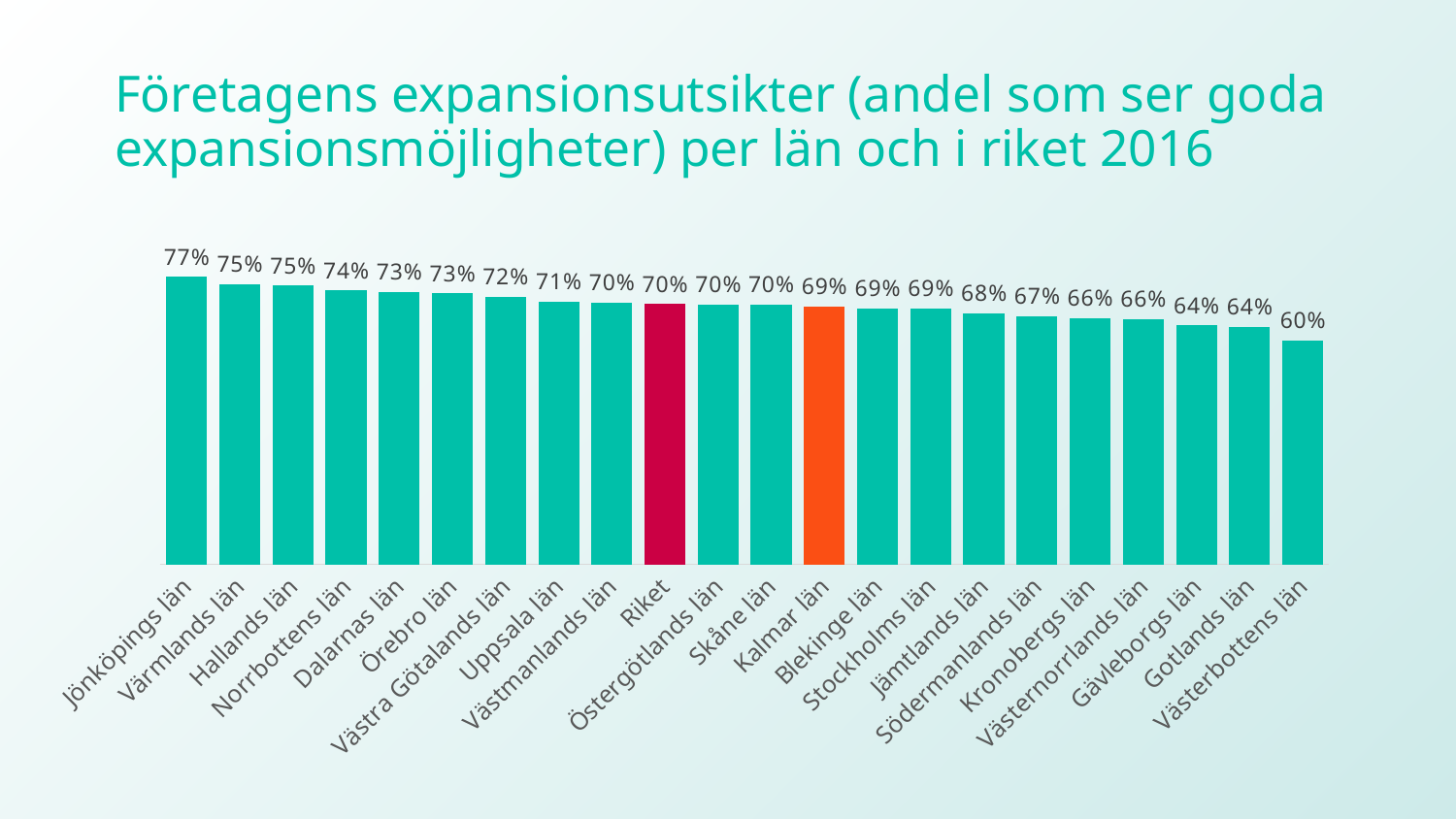
What is the difference between the values for Riket and Kalmar län? 1% What is the value for Riket? 70% How many bars are shown in the chart? 22 What kind of chart is shown on the slide? Bar chart Which bar is coloured orange? Kalmar län What is the value for Stockholms län? 69% Which category has the lowest value? Västerbottens län Which is larger, the value for Norrbottens län or the value for Gotlands län? Norrbottens län Which category has the highest value? Jönköpings län What is the difference between the values for Jönköpings län and Västerbottens län? 17% What is the value for Kalmar län? 69% What is the value for Jönköpings län? 77%